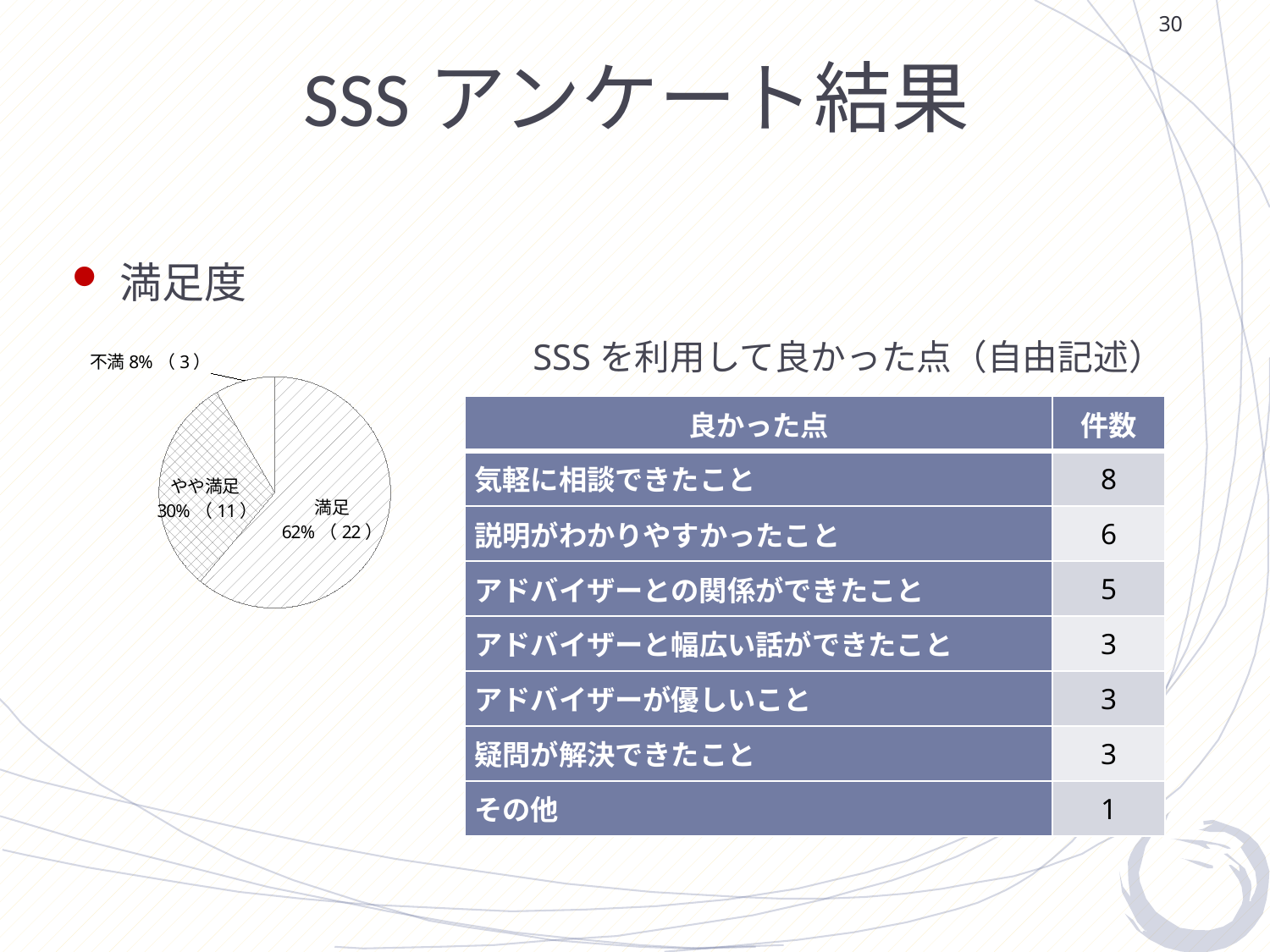
How many slices does the pie chart have? 3 What kind of chart is shown on the slide? pie chart How many responses does the 満足 slice represent? 22 How many responses does the やや満足 slice represent? 11 What percentage of the pie chart is やや満足? 30% Which slice is larger, やや満足 or 不満? やや満足 Which slice of the pie chart is the smallest? 不満 What percentage of the pie chart is 満足? 62% How many responses does the 不満 slice represent? 3 What is the difference in percentage points between the 満足 and やや満足 slices? 32 What percentage of the pie chart is 不満? 8% Which slice of the pie chart is the largest? 満足